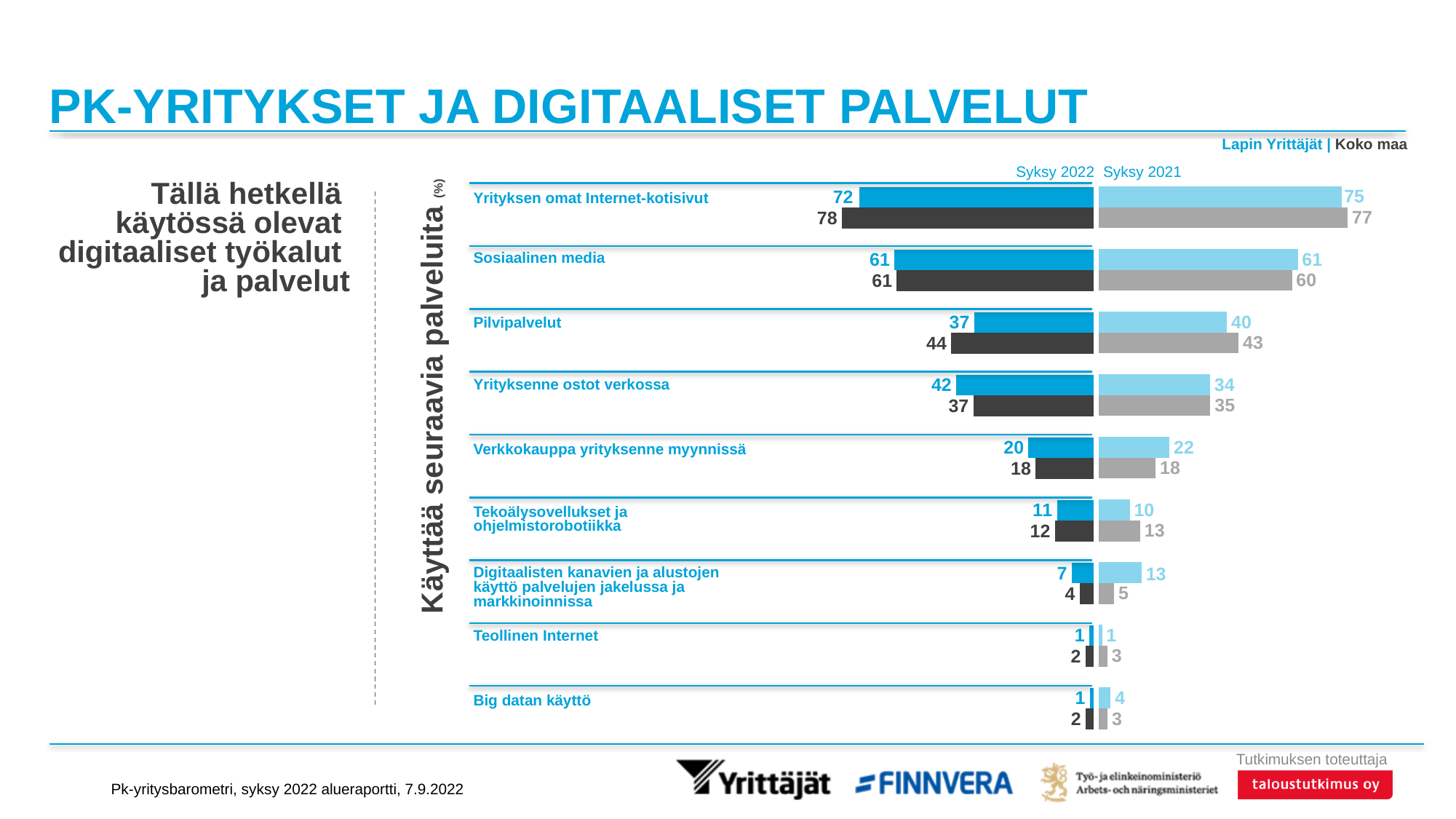
Which category has the highest Lapin Yrittäjät value in Syksy 2022? Yrityksen omat Internet-kotisivut What is the Koko maa value for Pilvipalvelut in Syksy 2022? 44 What is the Lapin Yrittäjät value for Yrityksenne ostot verkossa in Syksy 2021? 34 How many categories of digital tools and services are listed in the chart? 9 What kind of chart is shown on the slide? Bar chart Which category has the lowest Koko maa value in Syksy 2021? Teollinen Internet and Big datan käyttö (both 3) Which two groups are compared in the chart legend? Lapin Yrittäjät and Koko maa For Yrityksenne ostot verkossa in Syksy 2022, which is larger: the Lapin Yrittäjät value or the Koko maa value? Lapin Yrittäjät What percentage of Lapin Yrittäjät respondents used Yrityksen omat Internet-kotisivut in Syksy 2022? 72 What is the Koko maa value for Sosiaalinen media in Syksy 2021? 60 What is the difference between the Syksy 2021 and Syksy 2022 Lapin Yrittäjät values for Digitaalisten kanavien ja alustojen käyttö palvelujen jakelussa ja markkinoinnissa? 6 What is the difference between the Lapin Yrittäjät and Koko maa values for Yrityksen omat Internet-kotisivut in Syksy 2022? 6